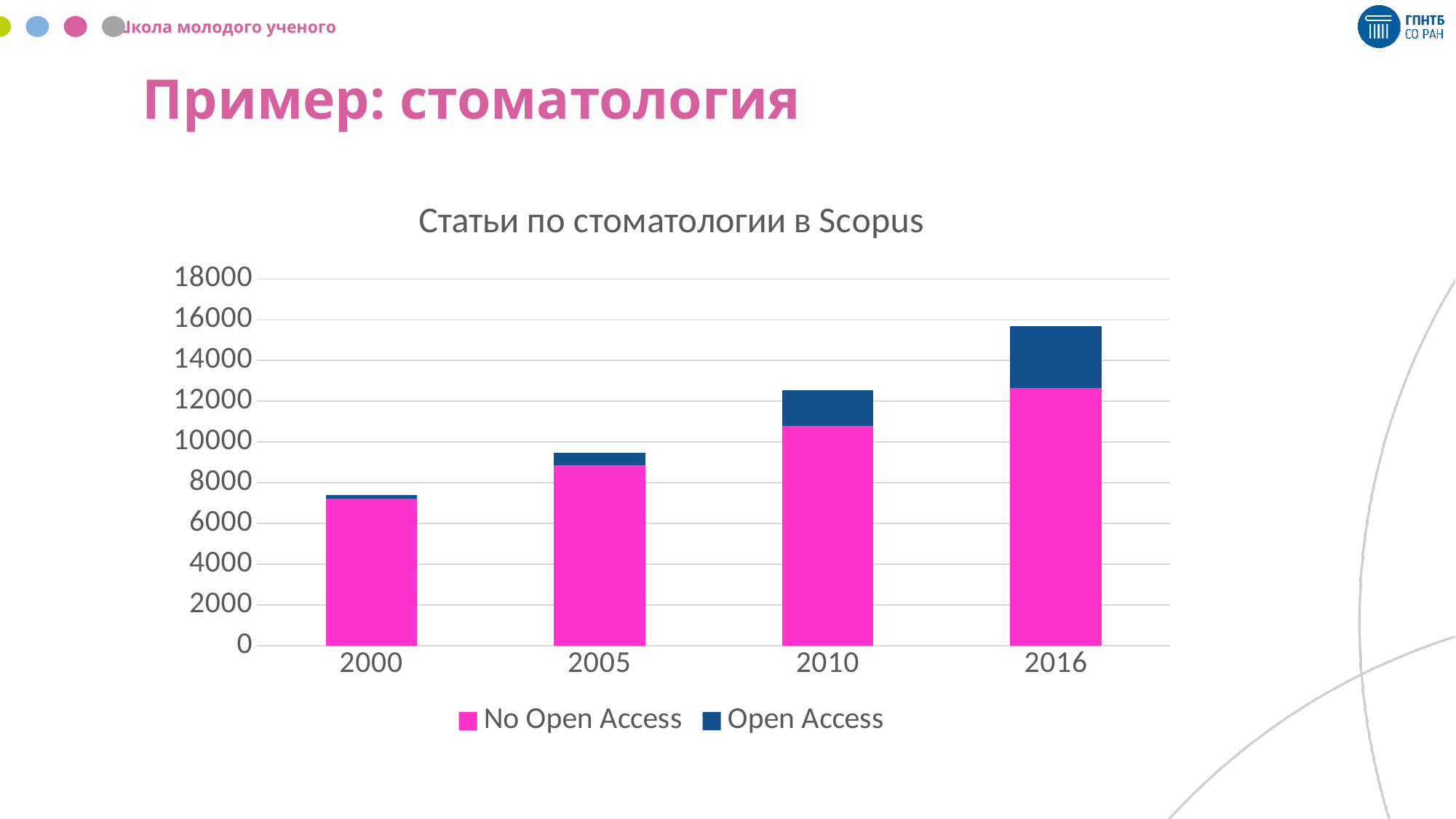
Which year has a larger total bar, 2005 or 2010? 2010 Which colour represents the Open Access series? Dark blue What kind of chart is shown on the slide? Stacked bar chart Which year has the lowest total bar? 2000 What is the title of the chart? Статьи по стоматологии в Scopus How many years are shown on the x axis? 4 Is the No Open Access value for 2010 greater or less than 10000? greater Which year has the highest total bar? 2016 How many series does the legend list? 2 Is the total bar for 2016 greater or less than 14000? greater Is the total bar for 2000 greater or less than 8000? less Do the total bar heights rise or fall from 2000 to 2016? Rise